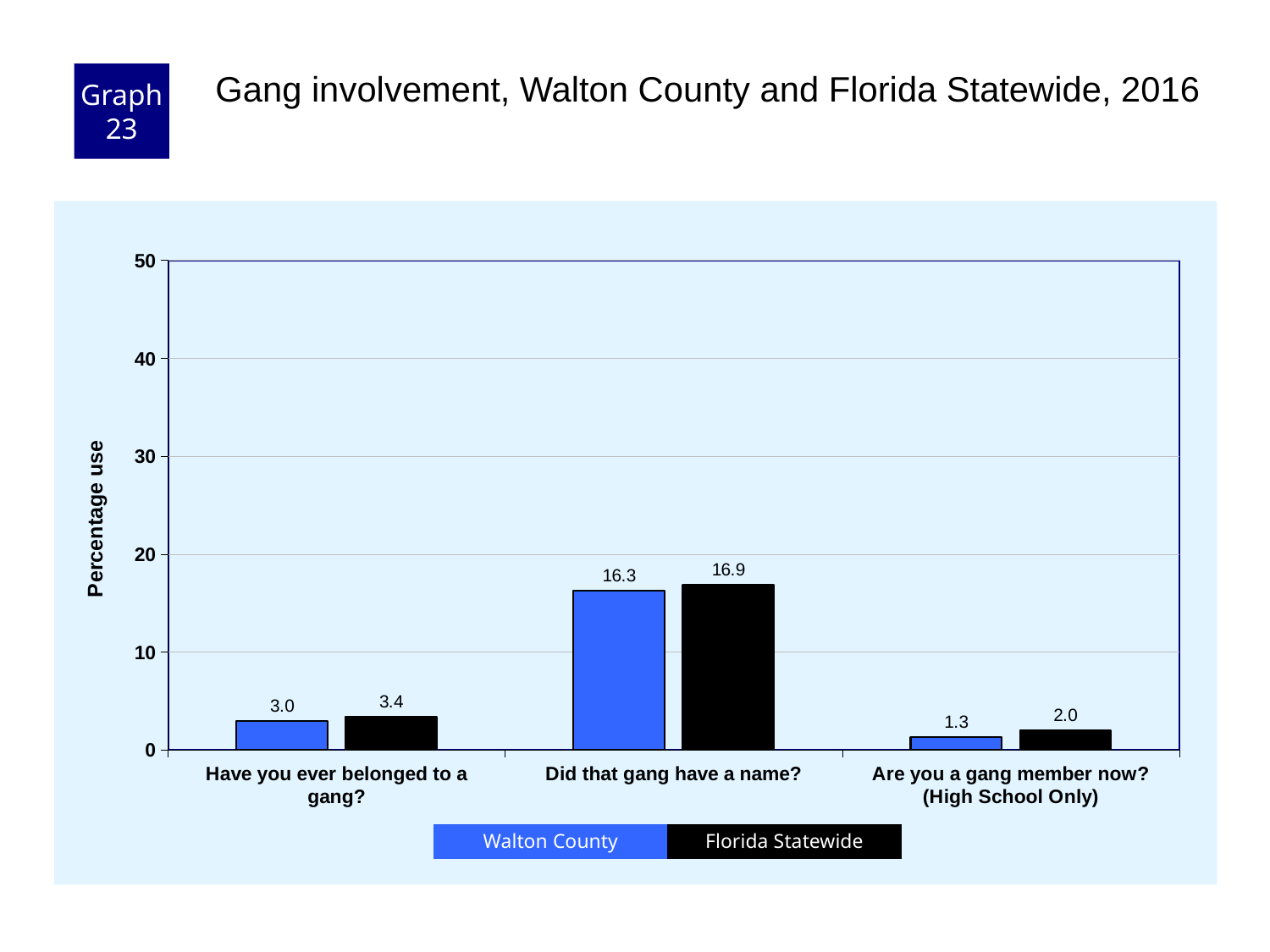
What is the Walton County value for "Did that gang have a name?"? 16.3 What is the Florida Statewide value for "Have you ever belonged to a gang?"? 3.4 What is the label of the y axis? Percentage use Is the Florida Statewide value for "Did that gang have a name?" greater or less than 20? less Which question category has the highest Florida Statewide value? Did that gang have a name? What is the difference between the Florida Statewide and Walton County values for "Did that gang have a name?"? 0.6 What kind of chart is shown on the slide? Bar chart How many question categories are shown on the x axis? 3 How many series does the legend list? 2 What is the Walton County value for "Are you a gang member now? (High School Only)"? 1.3 Which question category has the lowest Walton County value? Are you a gang member now? (High School Only) For "Are you a gang member now? (High School Only)", which is larger: Walton County or Florida Statewide? Florida Statewide